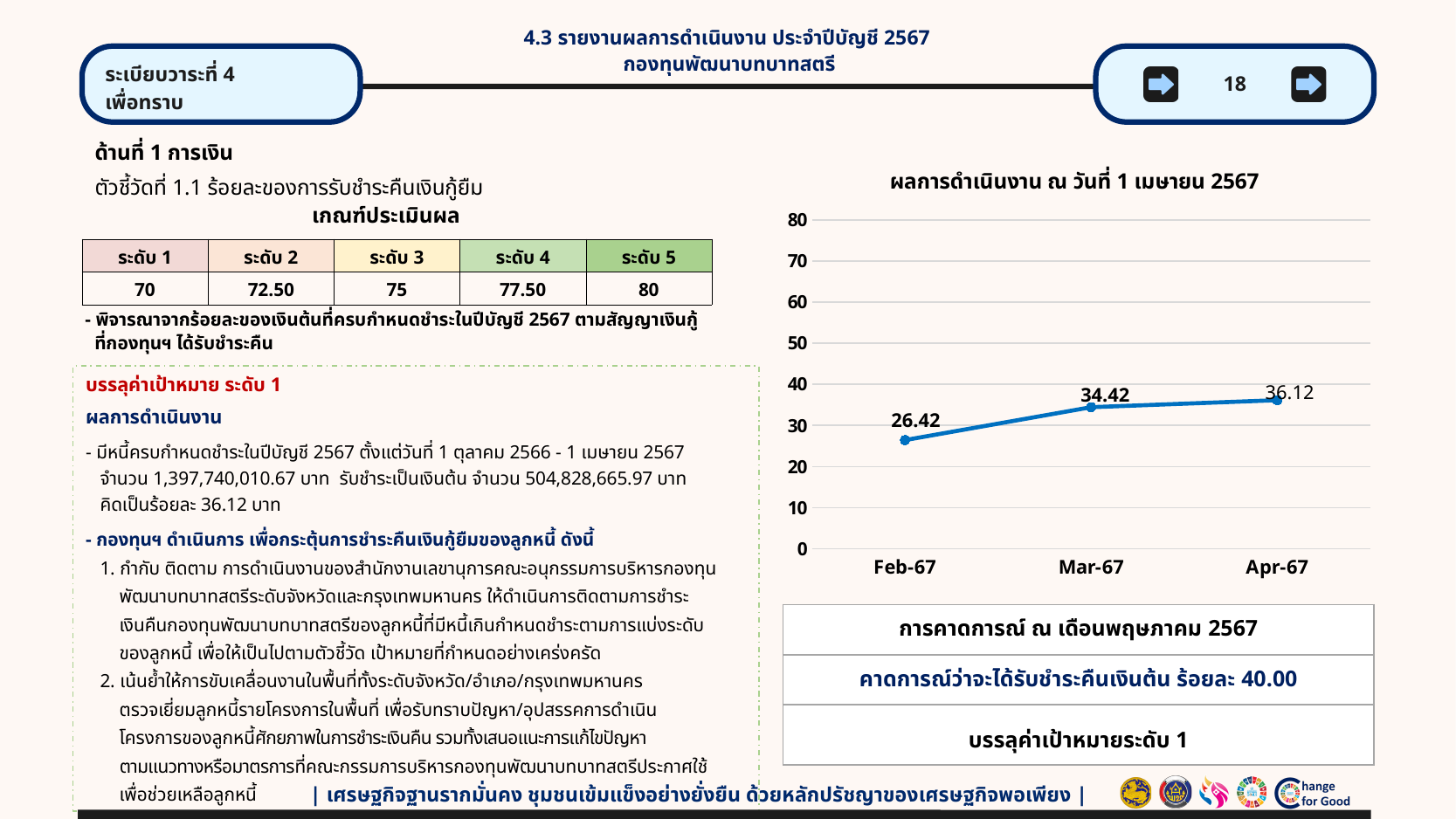
What is the value for Mar-67 in the line chart? 34.42 Which is larger, the value for Feb-67 or the value for Mar-67? Mar-67 What is the value for Feb-67 in the line chart? 26.42 Do the values rise or fall from Feb-67 to Apr-67? rise How many data points are plotted in the line chart? 3 Is the value for Apr-67 greater or less than 40? less What is the value for Apr-67 in the line chart? 36.12 What is the difference between the values for Mar-67 and Feb-67? 8.00 What type of chart is shown on the slide? line chart Which month has the lowest value in the line chart? Feb-67 Which month has the highest value in the line chart? Apr-67 What is the difference between the values for Apr-67 and Mar-67? 1.70